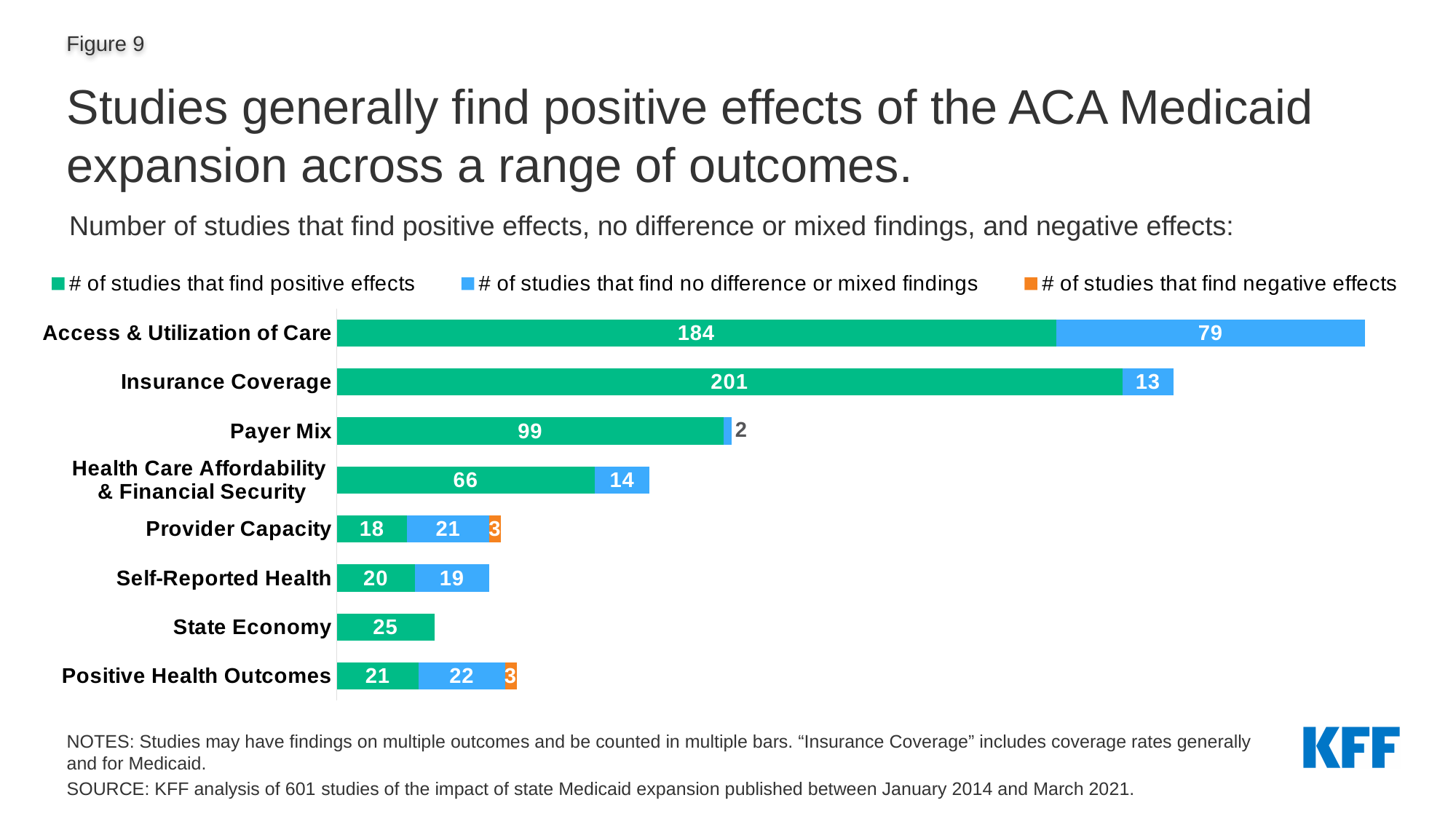
How many categories are shown on the chart? 8 What kind of chart is shown on the slide? Stacked bar chart How many studies find positive effects for Access & Utilization of Care? 184 What is the difference between the number of studies finding positive effects for Insurance Coverage and for Access & Utilization of Care? 17 How many studies find negative effects for Provider Capacity? 3 How many series does the legend list? 3 Which has more studies finding no difference or mixed findings: Access & Utilization of Care or Health Care Affordability & Financial Security? Access & Utilization of Care What is the total number of studies in the Positive Health Outcomes bar? 46 Which category has the highest number of studies that find positive effects? Insurance Coverage How many studies find no difference or mixed findings for Insurance Coverage? 13 Which colour represents studies that find negative effects? Orange Which category has the lowest number of studies that find positive effects? Provider Capacity